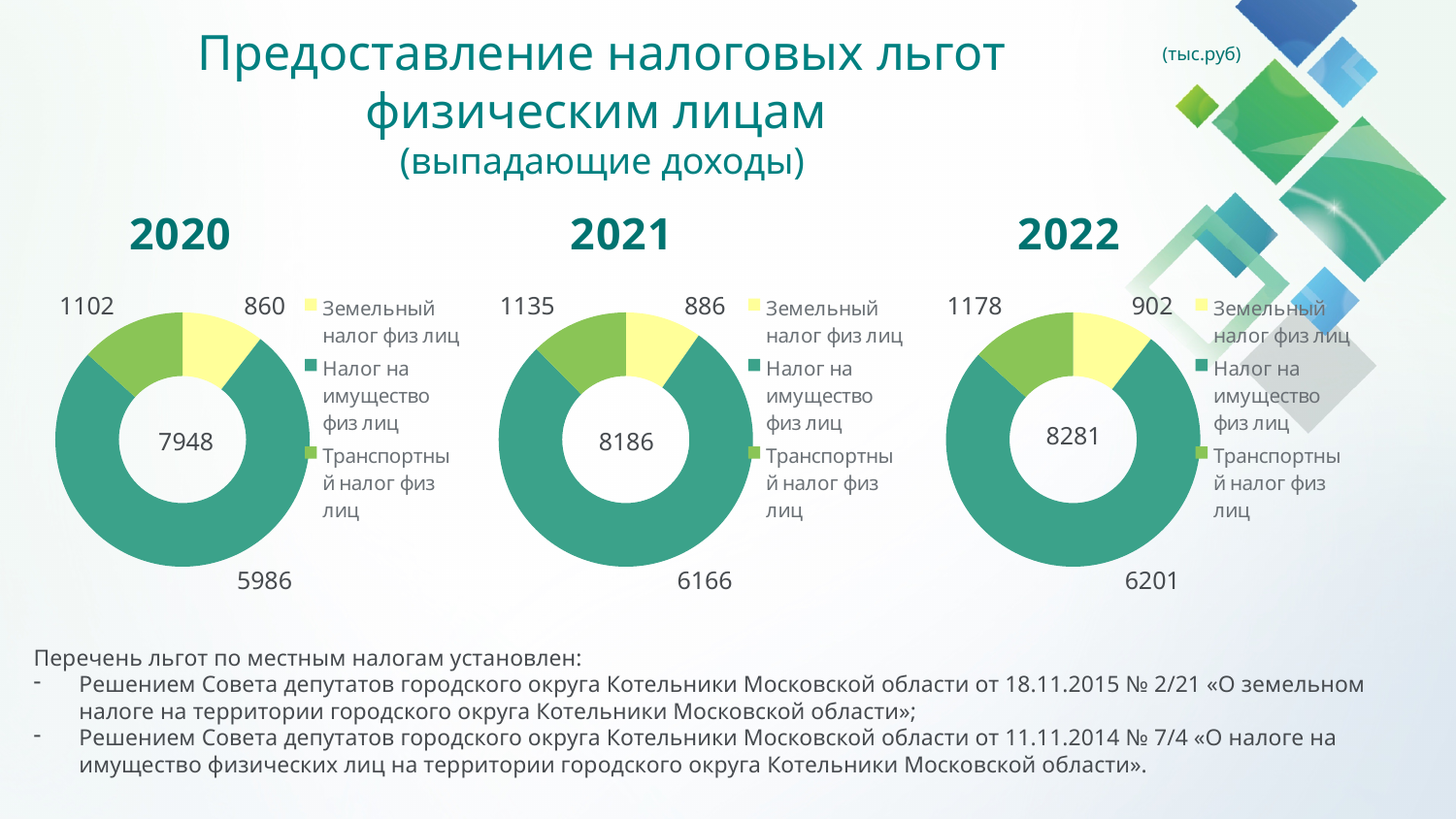
In the 2020 chart, what is the value for Налог на имущество физ лиц? 5986 In the 2020 chart, which is larger: Транспортный налог физ лиц or Земельный налог физ лиц? Транспортный налог физ лиц In the 2021 chart, which category has the largest value? Налог на имущество физ лиц In the 2022 chart, what is the difference between Налог на имущество физ лиц and Транспортный налог физ лиц? 5023 In the 2022 chart, what is the value for Транспортный налог физ лиц? 1178 In the 2021 chart, what is the value for Земельный налог физ лиц? 886 What unit is indicated in the top right of the slide for the chart values? тыс.руб How many slices does the 2021 chart have? 3 How many series does the legend of the 2022 chart list? 3 What kind of chart is used for 2020? Donut (pie) chart In the 2020 chart, which category has the smallest value? Земельный налог физ лиц In the 2022 chart, what total is shown in the centre of the donut? 8281